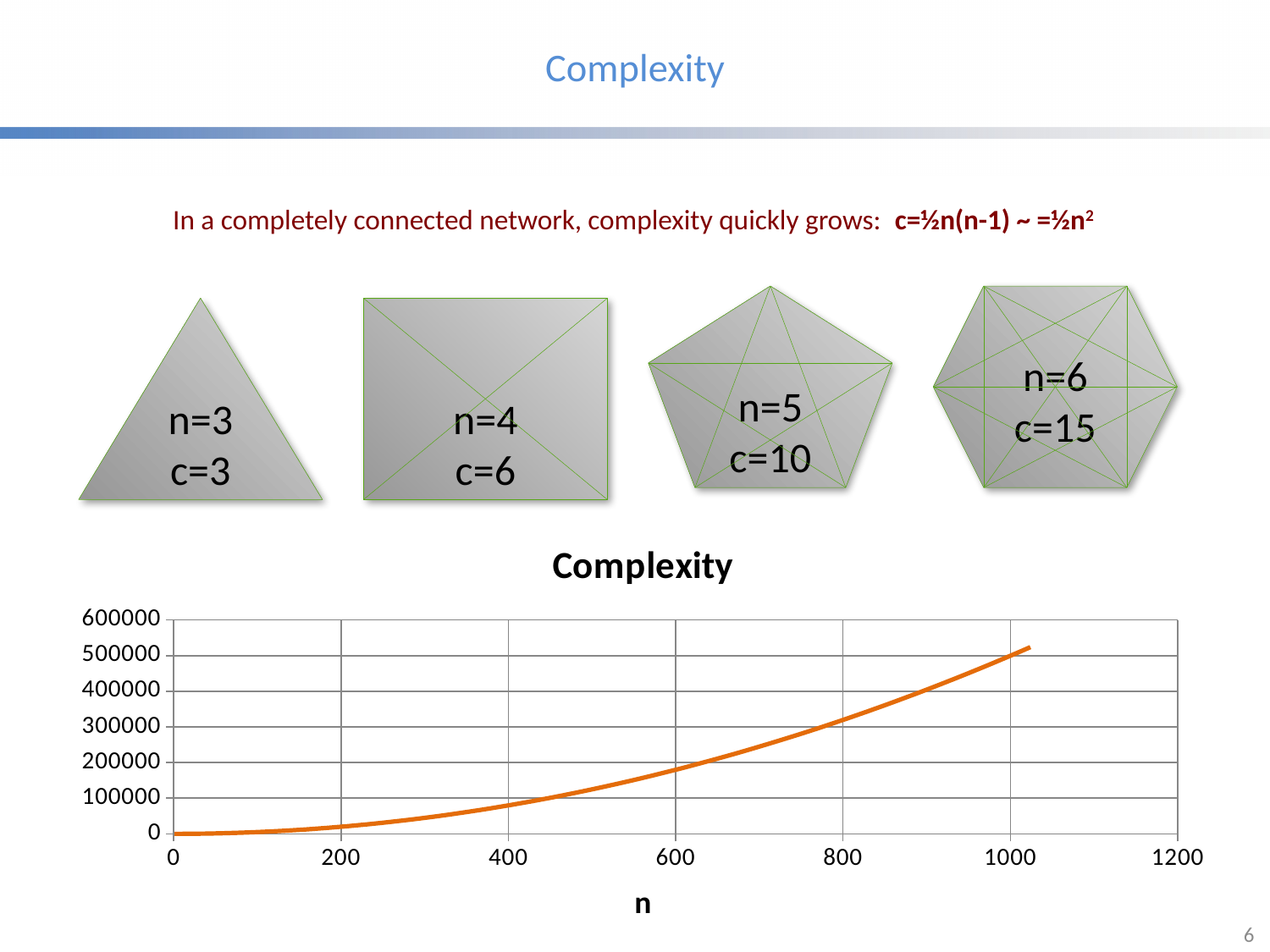
Is the value for n=800 greater or less than 400000? less Is the value for n=600 greater or less than 100000? greater Is the value for n=200 greater or less than 100000? less What is the label of the x axis of the chart? n What is the title of the chart? Complexity What kind of chart is shown on the slide? line chart Do the values on the chart rise or fall as n increases? rise